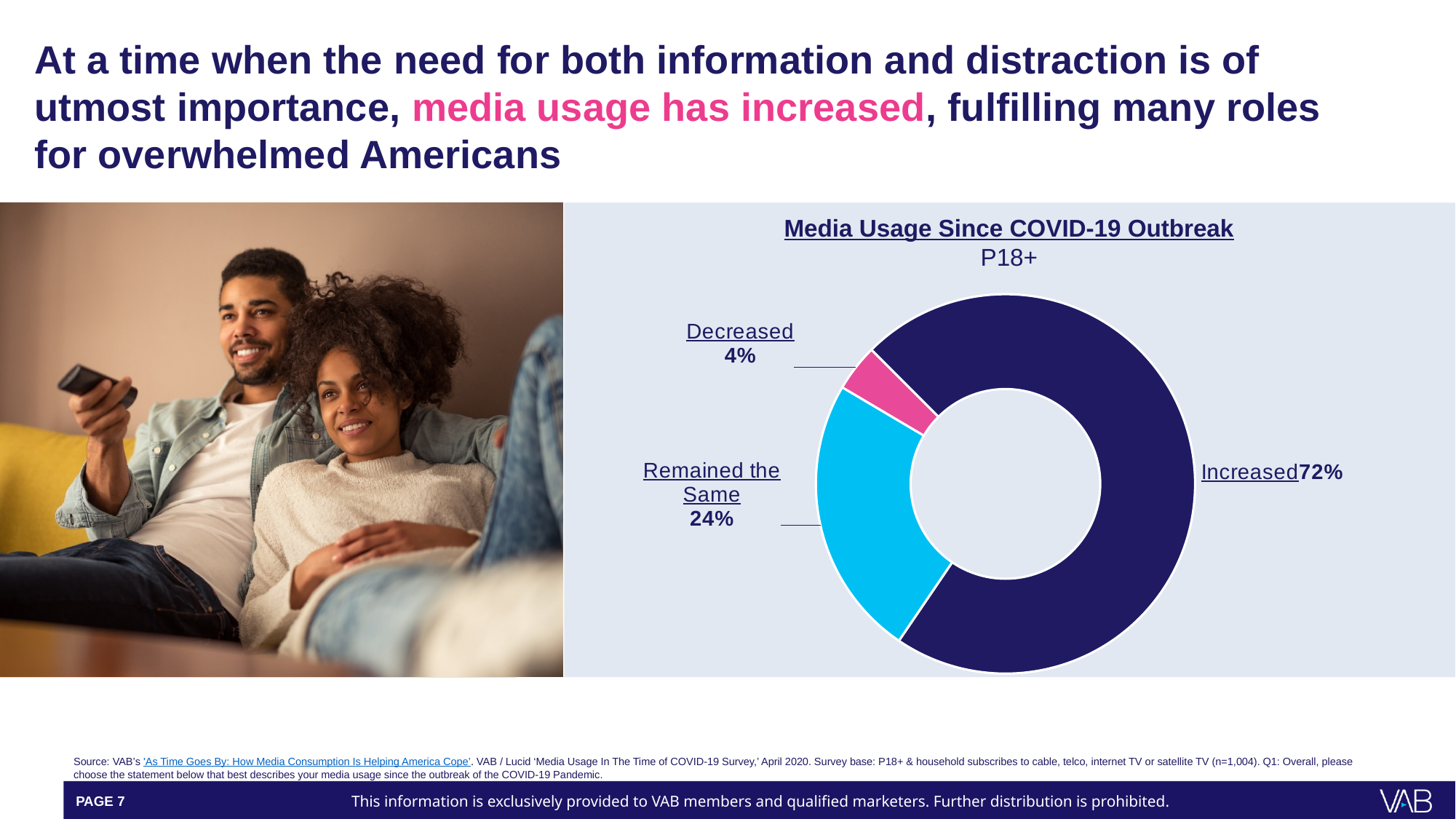
Which category has the largest share of the chart? Increased What is the difference in percentage points between Increased and Remained the Same? 48 What percentage of respondents said their media usage Increased? 72% What kind of chart is shown on the slide? Doughnut (pie) chart Which is larger, the share for Remained the Same or the share for Decreased? Remained the Same How many categories are shown in the chart? 3 Which category has the smallest share of the chart? Decreased What is the difference in percentage points between Remained the Same and Decreased? 20 What is the title of the chart? Media Usage Since COVID-19 Outbreak What population group does the chart subtitle say the data covers? P18+ What percentage of respondents said their media usage Remained the Same? 24% What percentage of respondents said their media usage Decreased? 4%